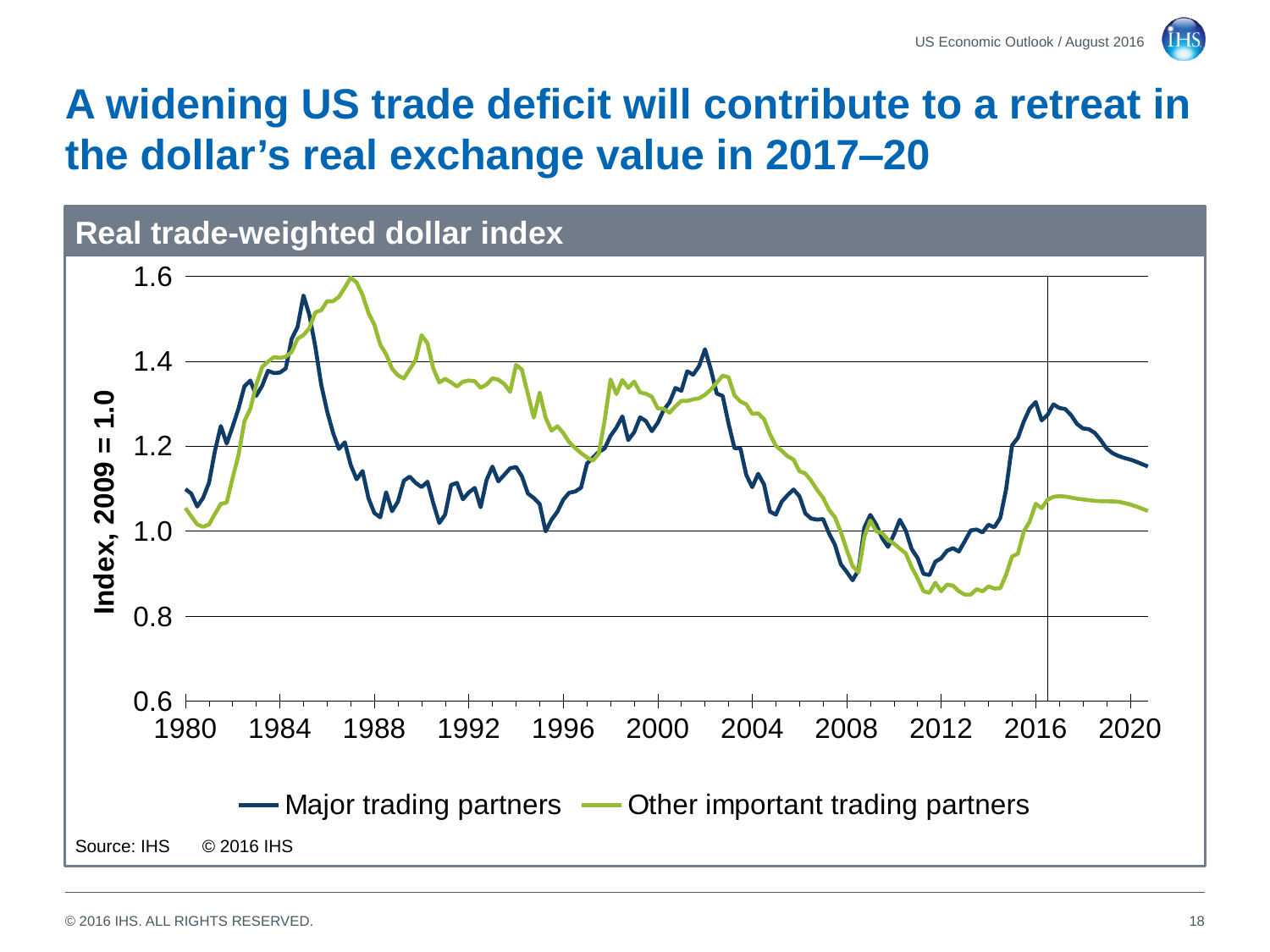
What is the title of the chart? Real trade-weighted dollar index Does the Major trading partners line rise or fall between 2016 and 2020? Falls In 1987, which series has the higher value, Major trading partners or Other important trading partners? Other important trading partners How many series does the legend list? 2 Is the value for Major trading partners in 2020 greater or less than 1.0? greater Does the Other important trading partners line rise or fall between 2012 and 2016? Rises In 2016, which series has the higher value, Major trading partners or Other important trading partners? Major trading partners What is the label of the y axis? Index, 2009 = 1.0 Is the value for Other important trading partners in 1987 greater or less than 1.4? greater Is the value for Other important trading partners in 2012 greater or less than 1.0? less What kind of chart is shown on the slide? Line chart